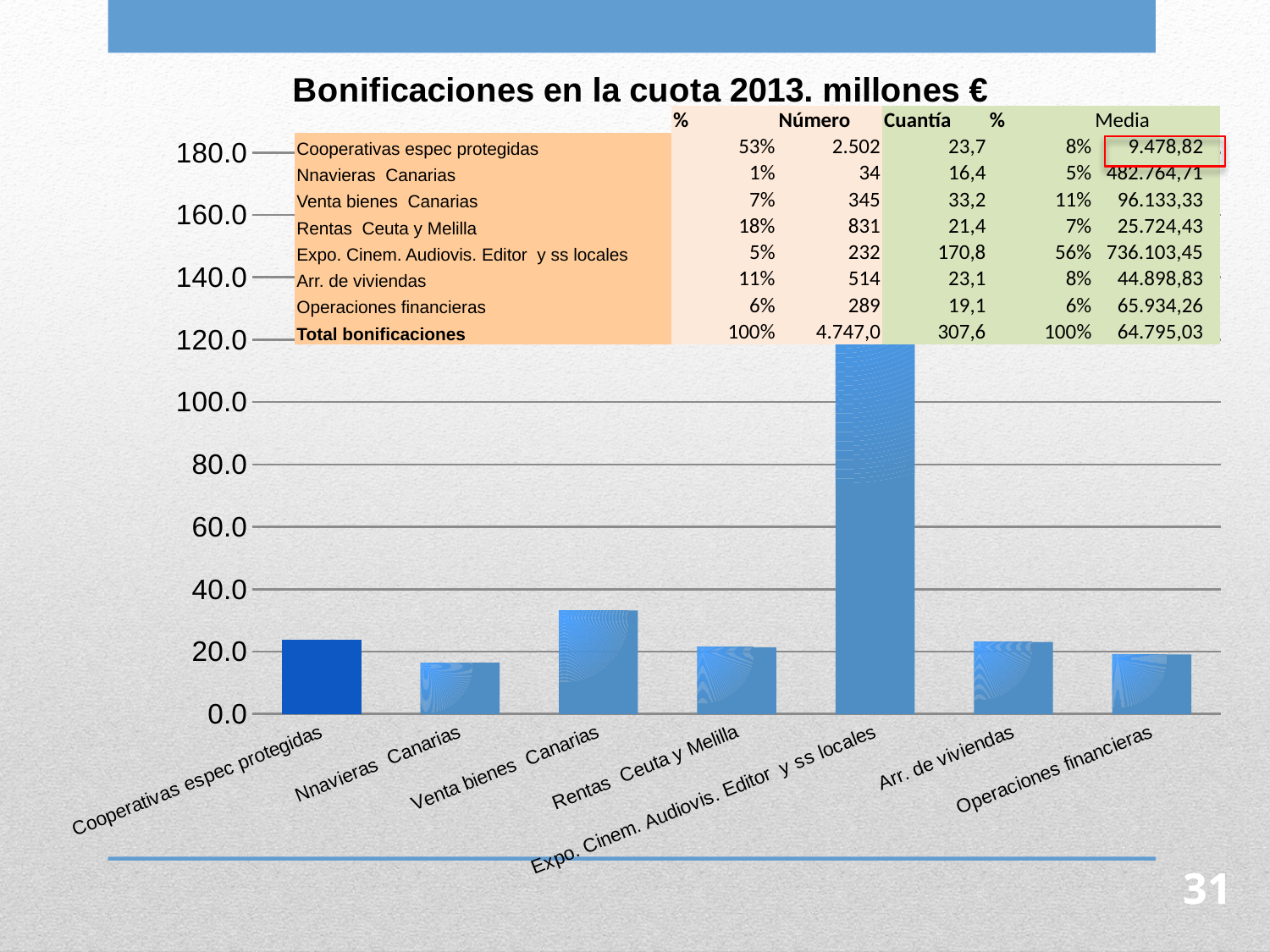
According to the table on the slide, what is the Cuantía for Cooperativas espec protegidas? 23,7 Is the bar for Cooperativas espec protegidas greater or less than 20? greater What kind of chart is shown on the slide? bar chart Which category has the tallest bar in the chart? Expo. Cinem. Audiovis. Editor y ss locales What is the title of the chart? Bonificaciones en la cuota 2013. millones € Is the bar for Venta bienes Canarias greater or less than 40? less Using the Cuantía values in the table, what is the difference between Expo. Cinem. Audiovis. Editor y ss locales and Venta bienes Canarias? 137,6 Which category has the shortest bar in the chart? Nnavieras Canarias Is the bar for Expo. Cinem. Audiovis. Editor y ss locales greater or less than 100? greater According to the table on the slide, what is the Cuantía for Total bonificaciones? 307,6 Which bar is taller: Venta bienes Canarias or Rentas Ceuta y Melilla? Venta bienes Canarias How many categories are plotted along the x axis of the chart? 7